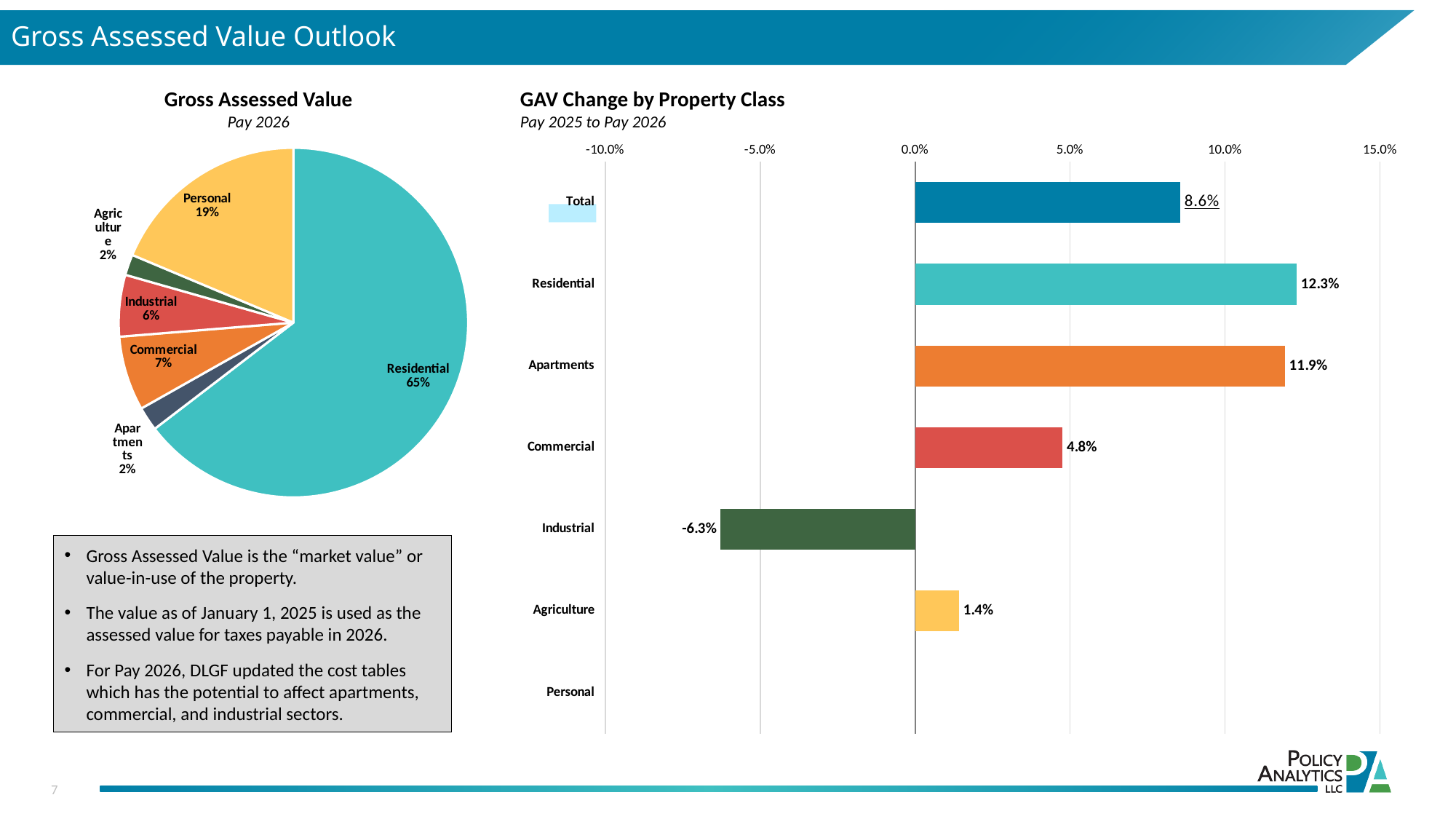
What kind of chart is 'GAV Change by Property Class'? Bar chart In the 'GAV Change by Property Class' chart, what is the difference between Apartments and Commercial? 7.1% In the 'Gross Assessed Value' pie chart, what share does Residential have? 65% In the 'Gross Assessed Value' pie chart, which category has the largest share? Residential In the 'GAV Change by Property Class' chart, what is the value for Total? 8.6% In the 'Gross Assessed Value' pie chart, what share does Personal have? 19% In the 'GAV Change by Property Class' chart, what is the value for Industrial? -6.3% In the 'Gross Assessed Value' pie chart, which is larger, Commercial or Industrial? Commercial In the 'GAV Change by Property Class' chart, what is the value for Residential? 12.3% In the 'GAV Change by Property Class' chart, which property class has the lowest value? Industrial What kind of chart is 'Gross Assessed Value'? Pie chart In the 'GAV Change by Property Class' chart, is the value for Agriculture greater or less than 5.0%? less